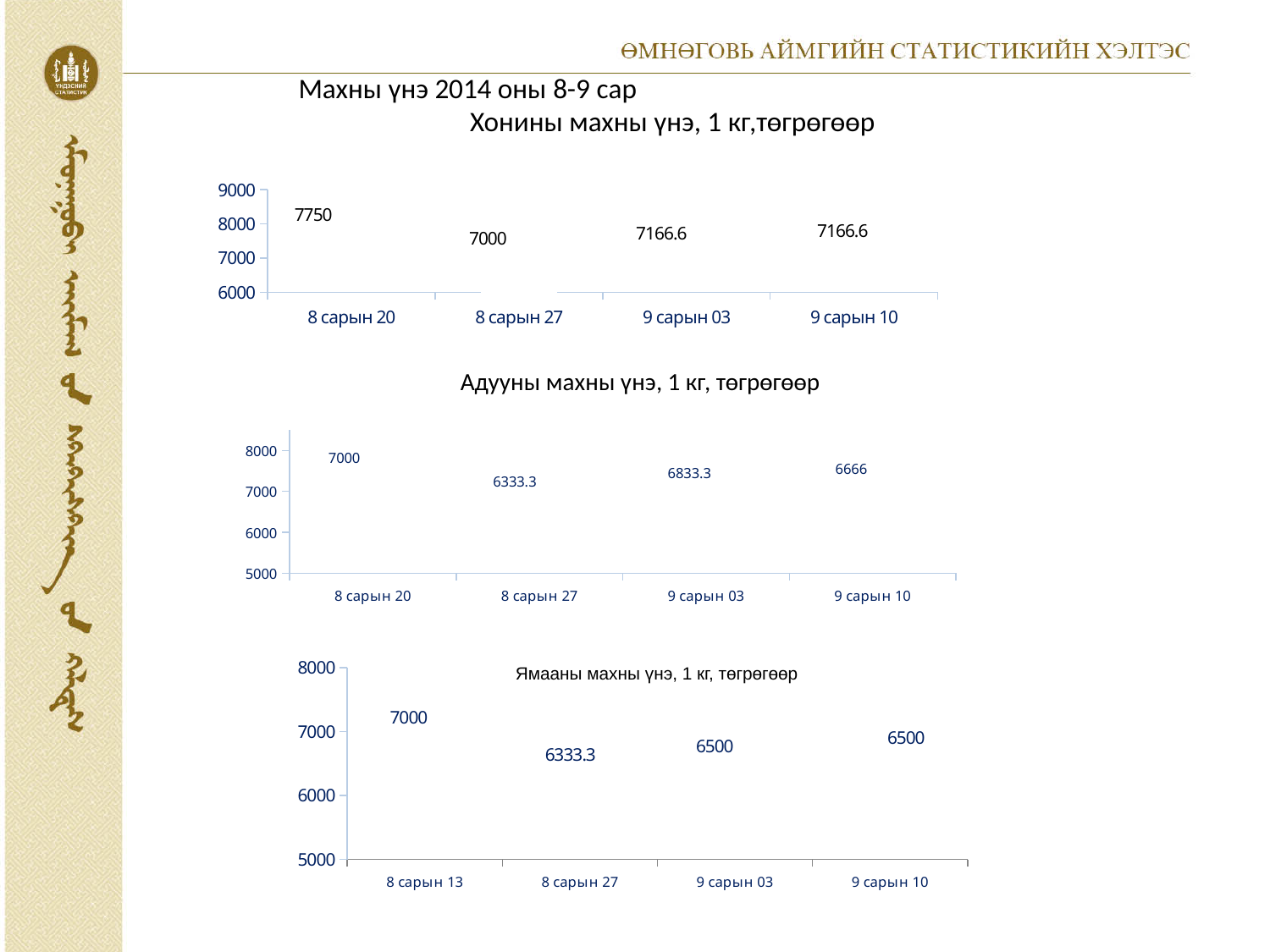
In the chart titled 'Хонины махны үнэ, 1 кг,төгрөгөөр', what is the value for 8 сарын 20? 7750 In the chart titled 'Хонины махны үнэ, 1 кг,төгрөгөөр', what is the difference between the values for 8 сарын 20 and 8 сарын 27? 750 How many charts are shown on the slide? 3 In the chart titled 'Ямааны махны үнэ, 1 кг, төгрөгөөр', which date has the lowest value? 8 сарын 27 In the chart titled 'Хонины махны үнэ, 1 кг,төгрөгөөр', how many dates are shown on the x axis? 4 In the chart titled 'Адууны махны үнэ, 1 кг, төгрөгөөр', which is larger: the value for 9 сарын 03 or the value for 9 сарын 10? 9 сарын 03 In the chart titled 'Ямааны махны үнэ, 1 кг, төгрөгөөр', what is the value for 8 сарын 13? 7000 In the chart titled 'Ямааны махны үнэ, 1 кг, төгрөгөөр', what is the value for 9 сарын 10? 6500 In the chart titled 'Адууны махны үнэ, 1 кг, төгрөгөөр', which date has the highest value? 8 сарын 20 In the chart titled 'Хонины махны үнэ, 1 кг,төгрөгөөр', which date has the lowest value? 8 сарын 27 In the chart titled 'Адууны махны үнэ, 1 кг, төгрөгөөр', what is the difference between the values for 9 сарын 03 and 8 сарын 27? 500 In the chart titled 'Адууны махны үнэ, 1 кг, төгрөгөөр', what is the value for 8 сарын 27? 6333.3